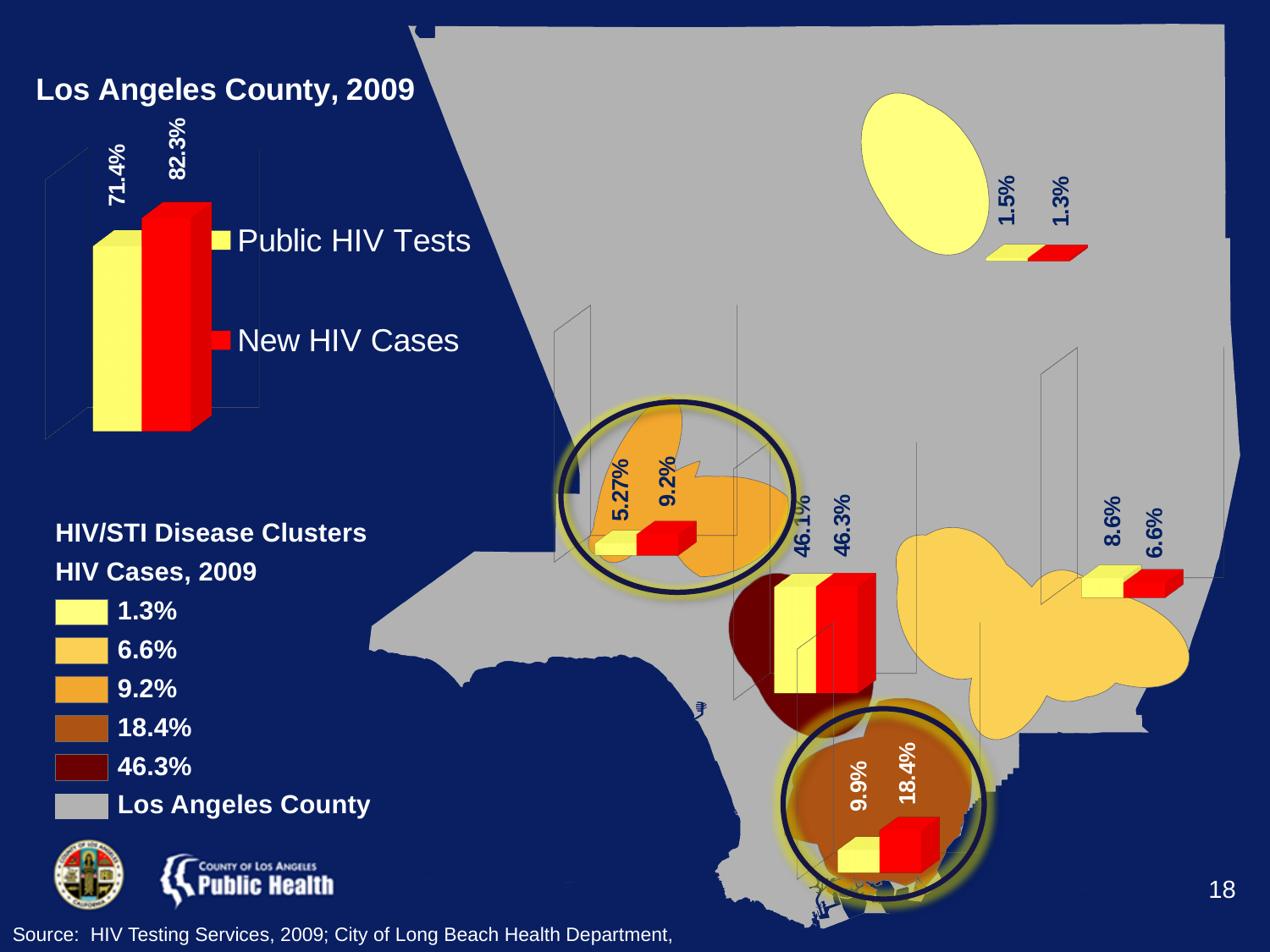
In the 'Los Angeles County, 2009' bar chart at the top left, what is the value for Public HIV Tests? 71.4% How many series does the legend of the 'Los Angeles County, 2009' chart list? 2 In the small bar chart on the map next to the yellow cluster in the north-east, what is the value for New HIV Cases (red bar)? 1.3% In the 'Los Angeles County, 2009' bar chart at the top left, what is the difference between New HIV Cases and Public HIV Tests? 10.9 percentage points In the small bar chart inside the circled cluster on the left of the map (the 9.2% cluster), which is larger, Public HIV Tests or New HIV Cases? New HIV Cases In the small bar chart inside the circled cluster at the bottom of the map (the 18.4% cluster), what is the value for New HIV Cases (red bar)? 18.4% In the small bar chart inside the circled cluster at the bottom of the map, what is the difference between New HIV Cases (18.4%) and Public HIV Tests (9.9%)? 8.5 percentage points In the 'Los Angeles County, 2009' bar chart at the top left, which is larger, Public HIV Tests or New HIV Cases? New HIV Cases What kind of chart is the 'Los Angeles County, 2009' chart at the top left? Bar chart In the small bar chart on the map next to the yellow cluster in the north-east, what is the value for Public HIV Tests (yellow bar)? 1.5% In the 'Los Angeles County, 2009' bar chart at the top left, what is the value for New HIV Cases? 82.3% In the 'Los Angeles County, 2009' chart, which colour represents New HIV Cases? Red